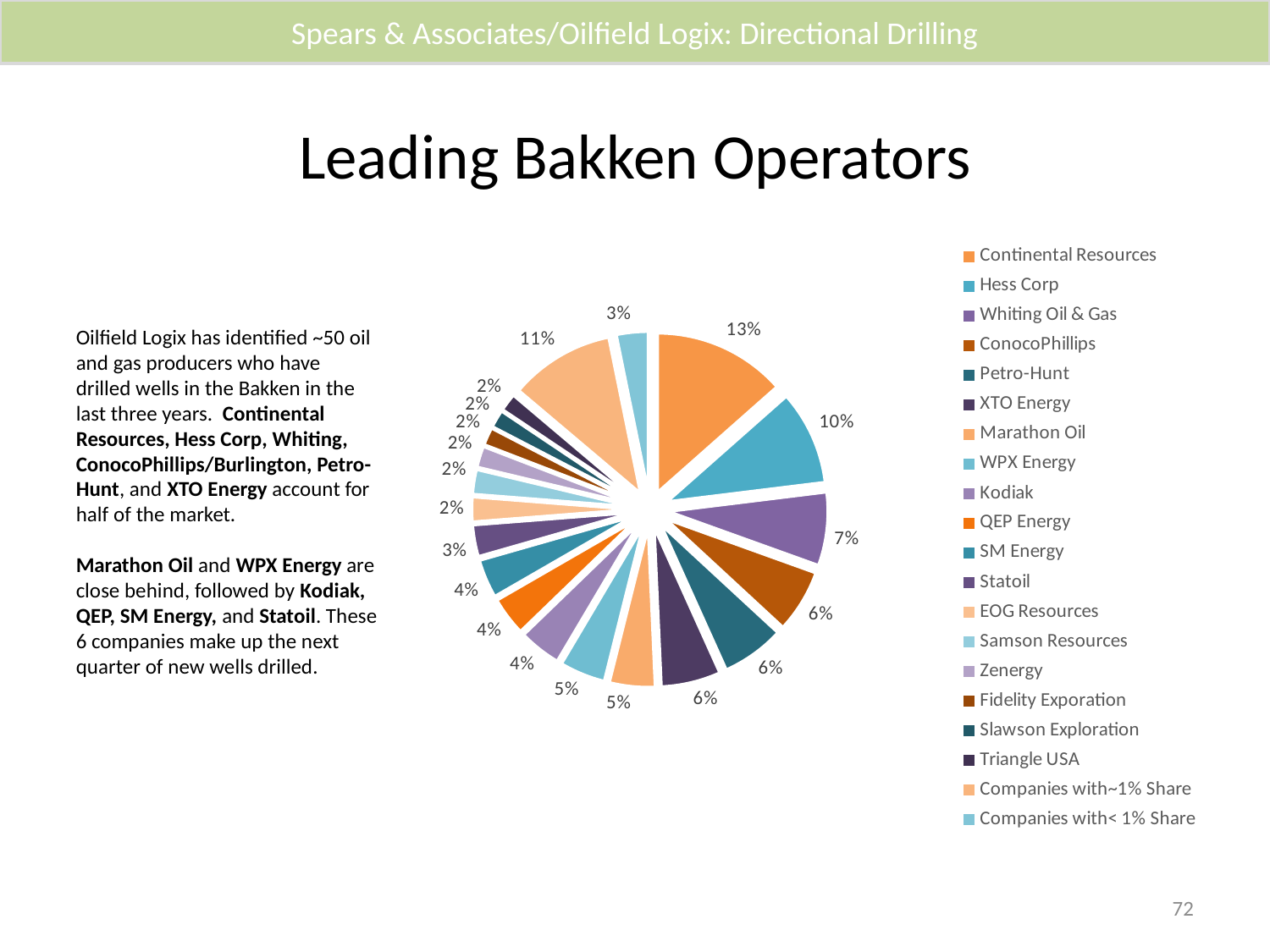
What is the title of the chart on the slide? Leading Bakken Operators By how many percentage points does Continental Resources' share exceed Hess Corp's share? 3 percentage points What share of the pie does Whiting Oil & Gas hold? 7% What share of the pie does Statoil hold? 3% What colour is the slice for Continental Resources? Orange Which single named operator has the largest slice of the pie? Continental Resources How many entries does the chart's legend list? 20 What share of the pie does Hess Corp hold? 10% What share of the pie does Continental Resources hold? 13% What share of the pie is labelled for Companies with ~1% Share? 11% What type of chart is shown on the slide? Pie chart Which has the larger share, Hess Corp or Whiting Oil & Gas? Hess Corp